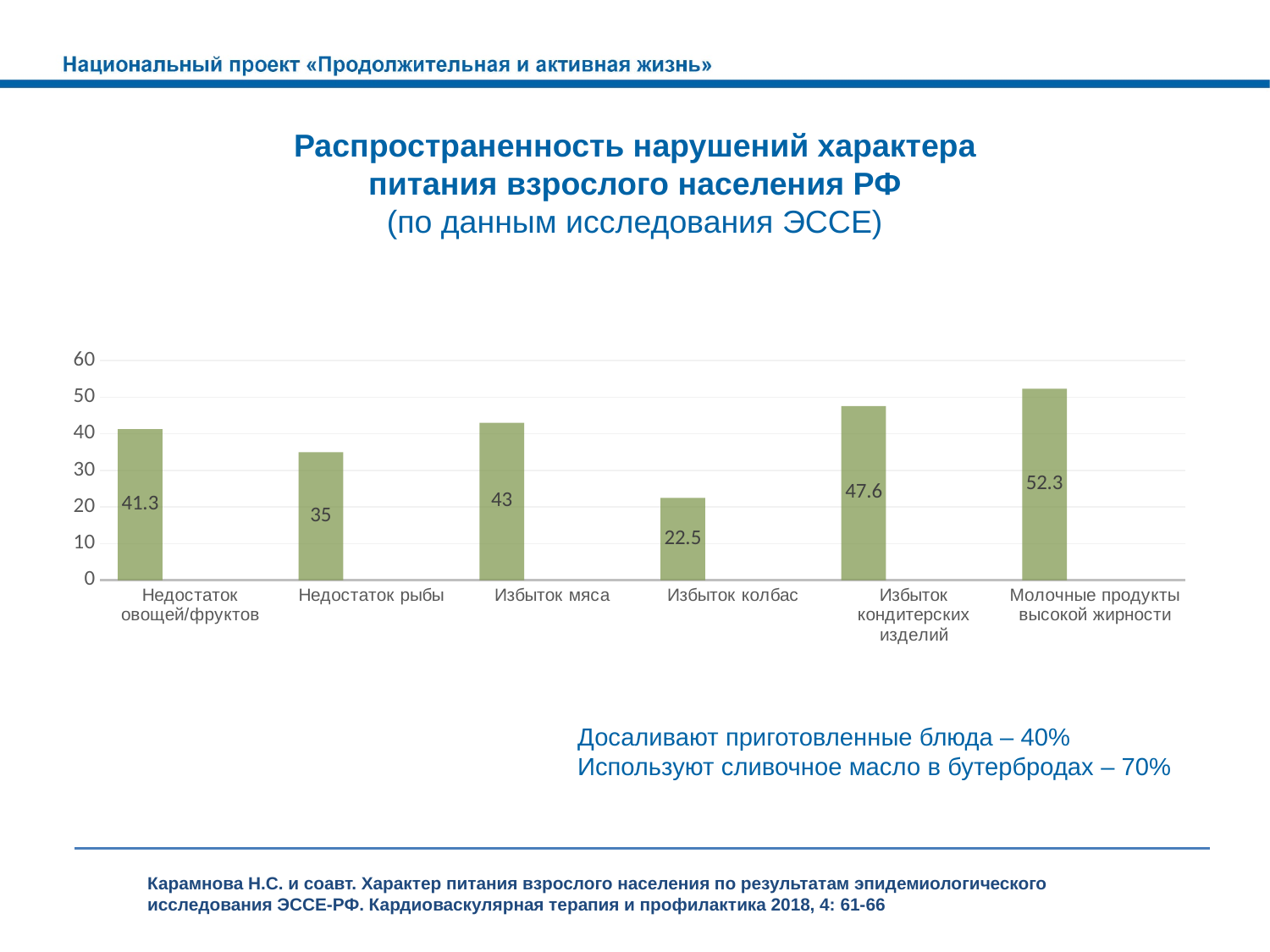
How many categories are shown in the chart? 6 What is the value for Молочные продукты высокой жирности? 52.3 What kind of chart is shown on the slide? bar chart What is the difference between the values for Избыток кондитерских изделий and Недостаток рыбы? 12.6 What is the value for Недостаток овощей/фруктов? 41.3 Which is larger, the value for Избыток мяса or the value for Недостаток овощей/фруктов? Избыток мяса Which category has the lowest value? Избыток колбас What is the value for Недостаток рыбы? 35 Is the value for Избыток кондитерских изделий greater or less than 40? greater What is the difference between the values for Молочные продукты высокой жирности and Избыток колбас? 29.8 What is the value for Избыток колбас? 22.5 Which category has the highest value? Молочные продукты высокой жирности